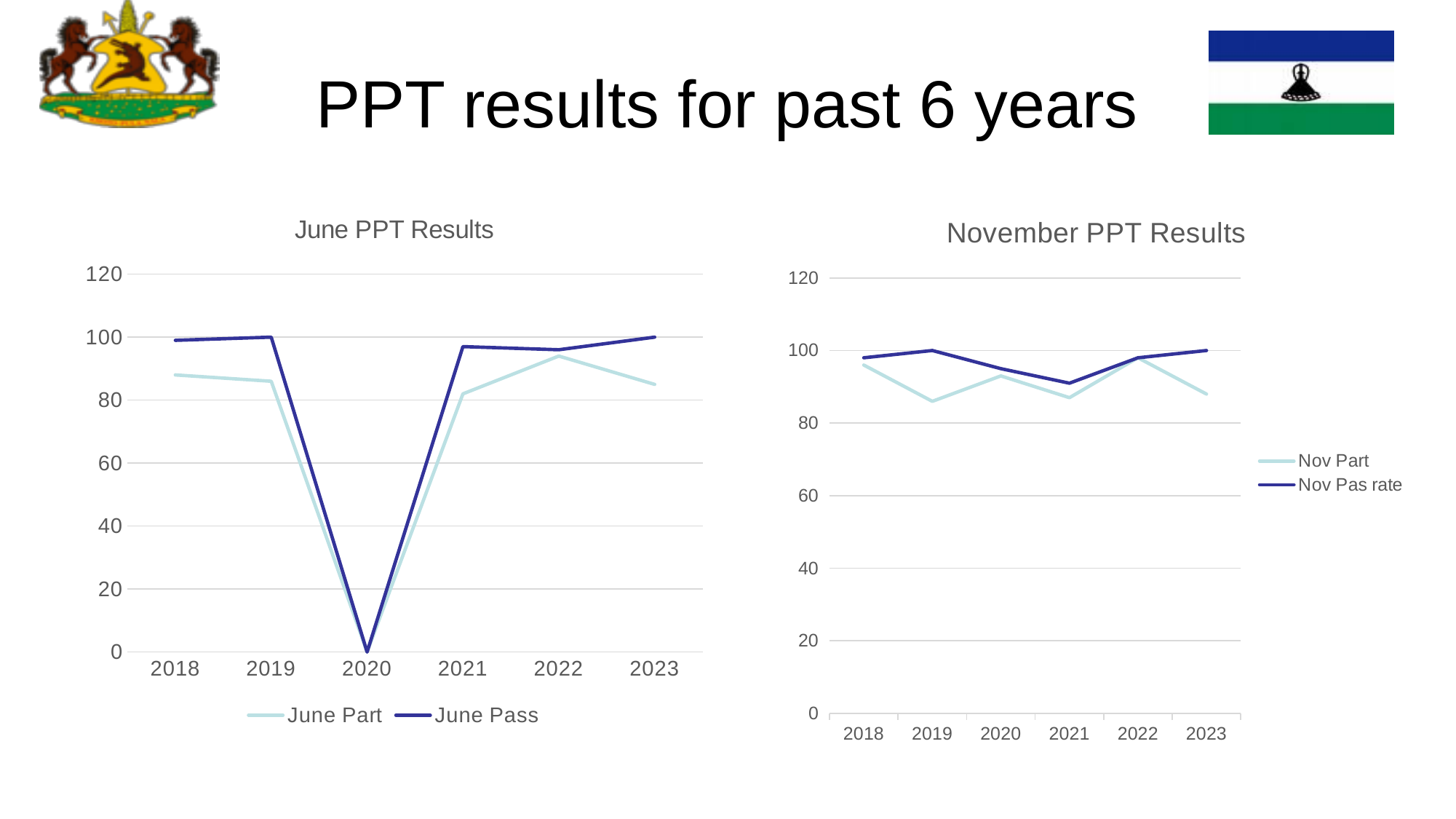
How many series does the legend of the November PPT Results chart list? 2 How many years are shown on the x axis of the June PPT Results chart? 6 In the November PPT Results chart, is the Nov Pas rate value for 2021 greater or less than 80? greater What are the two legend entries of the June PPT Results chart? June Part and June Pass In the June PPT Results chart, is the June Pass value for 2021 greater or less than 80? greater In the June PPT Results chart, is the June Part value for 2018 greater or less than 80? greater In the June PPT Results chart, what is the June Pass value for 2020? 0 What type of chart is the June PPT Results chart? line chart In the November PPT Results chart, which year has the lowest Nov Part value? 2019 In the November PPT Results chart, which is larger in 2023: Nov Part or Nov Pas rate? Nov Pas rate In the June PPT Results chart, which year has the lowest June Part value? 2020 In the June PPT Results chart, does the June Pass line rise or fall from 2021 to 2023? rise